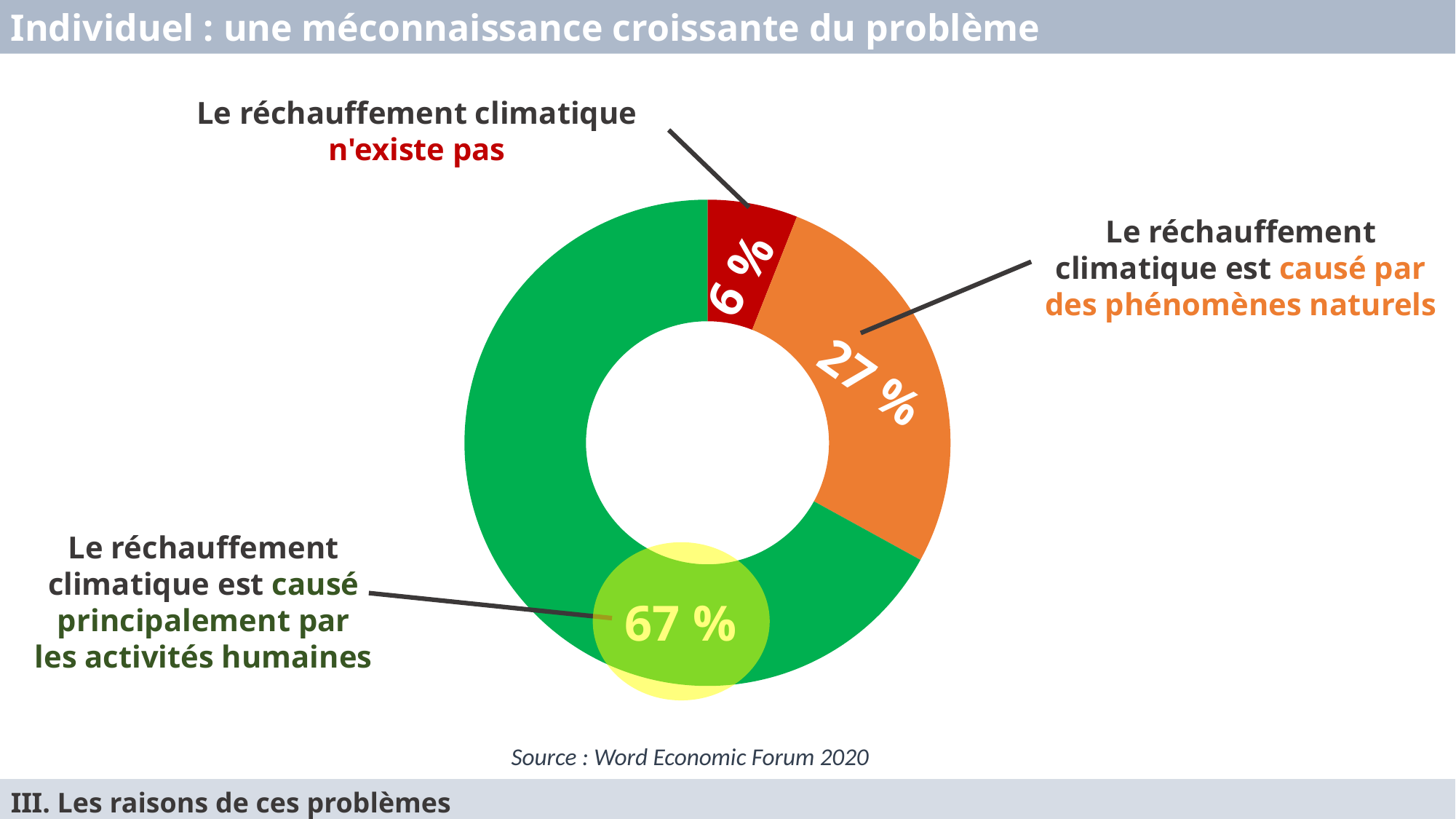
What is the difference in percentage points between the 'activités humaines' slice and the 'phénomènes naturels' slice? 40 What source is cited below the chart? Word Economic Forum 2020 What share of respondents say global warming is caused mainly by human activities? 67 % Which opinion has the largest share of the chart? Le réchauffement climatique est causé principalement par les activités humaines What share of respondents say global warming does not exist? 6 % Which is larger: the share for 'phénomènes naturels' or the share for 'n'existe pas'? phénomènes naturels What kind of chart is shown on the slide? Donut (pie) chart What share of respondents say global warming is caused by natural phenomena? 27 % Which opinion has the smallest share of the chart? Le réchauffement climatique n'existe pas What is the difference in percentage points between the 'phénomènes naturels' slice and the 'n'existe pas' slice? 21 What colour is the slice for 'Le réchauffement climatique n'existe pas'? Red How many slices does the chart have? 3